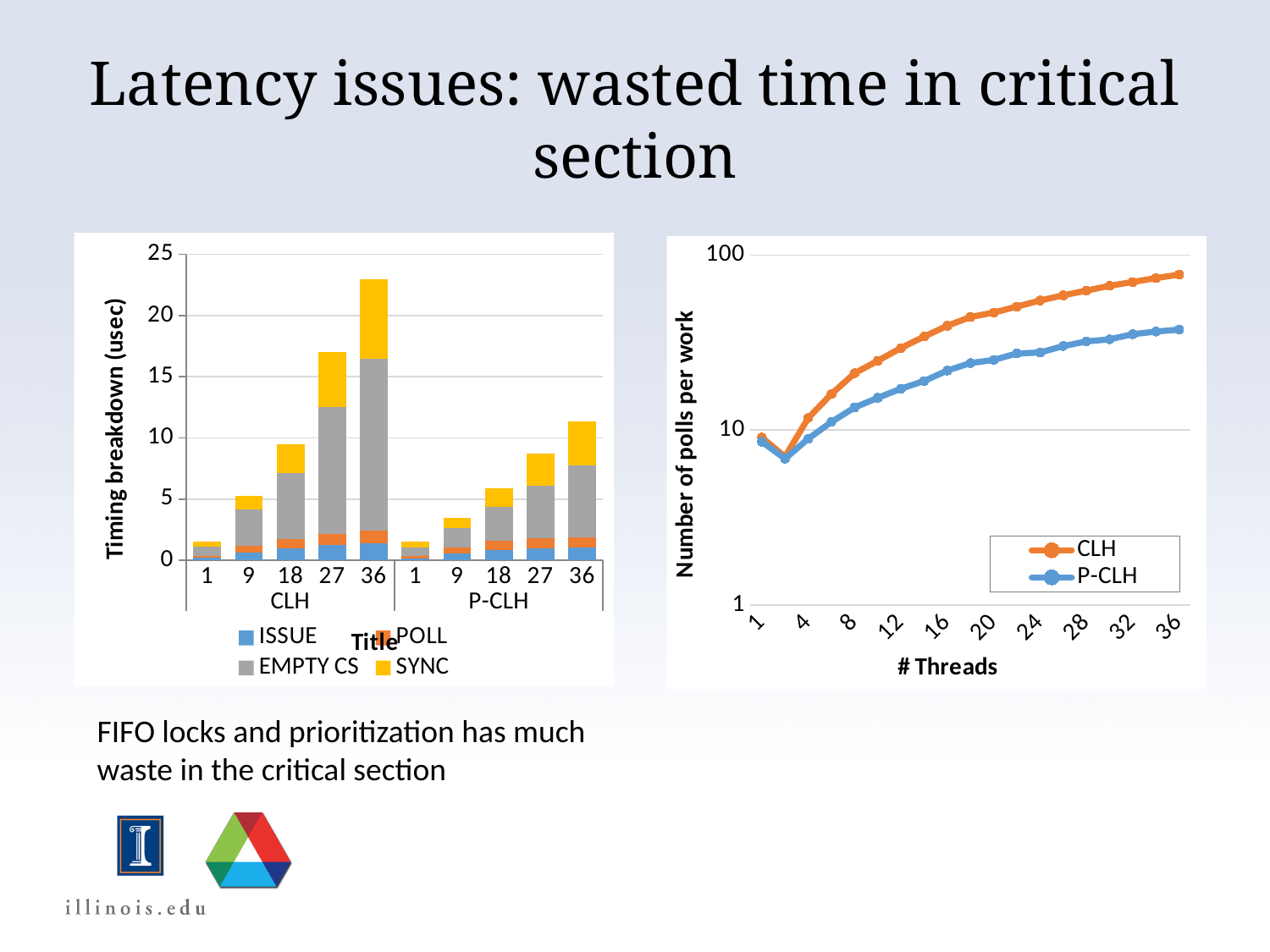
In the left chart, is the total for CLH at 36 greater or less than 20? greater In the right chart, how many series does the legend list? 2 In the right chart, which series has the higher number of polls per work at 36 threads? CLH In the left chart, which is larger: the total for CLH at 36 or the total for P-CLH at 36? CLH at 36 What kind of chart is the right chart on the slide? line chart What kind of chart is the left chart on the slide? stacked bar chart In the left chart, which bar has the highest total timing breakdown? CLH at 36 In the left chart, how many bars are plotted in total? 10 What is the y-axis title of the left chart? Timing breakdown (usec) In the left chart, is the total for P-CLH at 9 greater or less than 5? less In the left chart, how many series does the legend list? 4 In the right chart, is the value for CLH at 36 threads greater or less than 10? greater